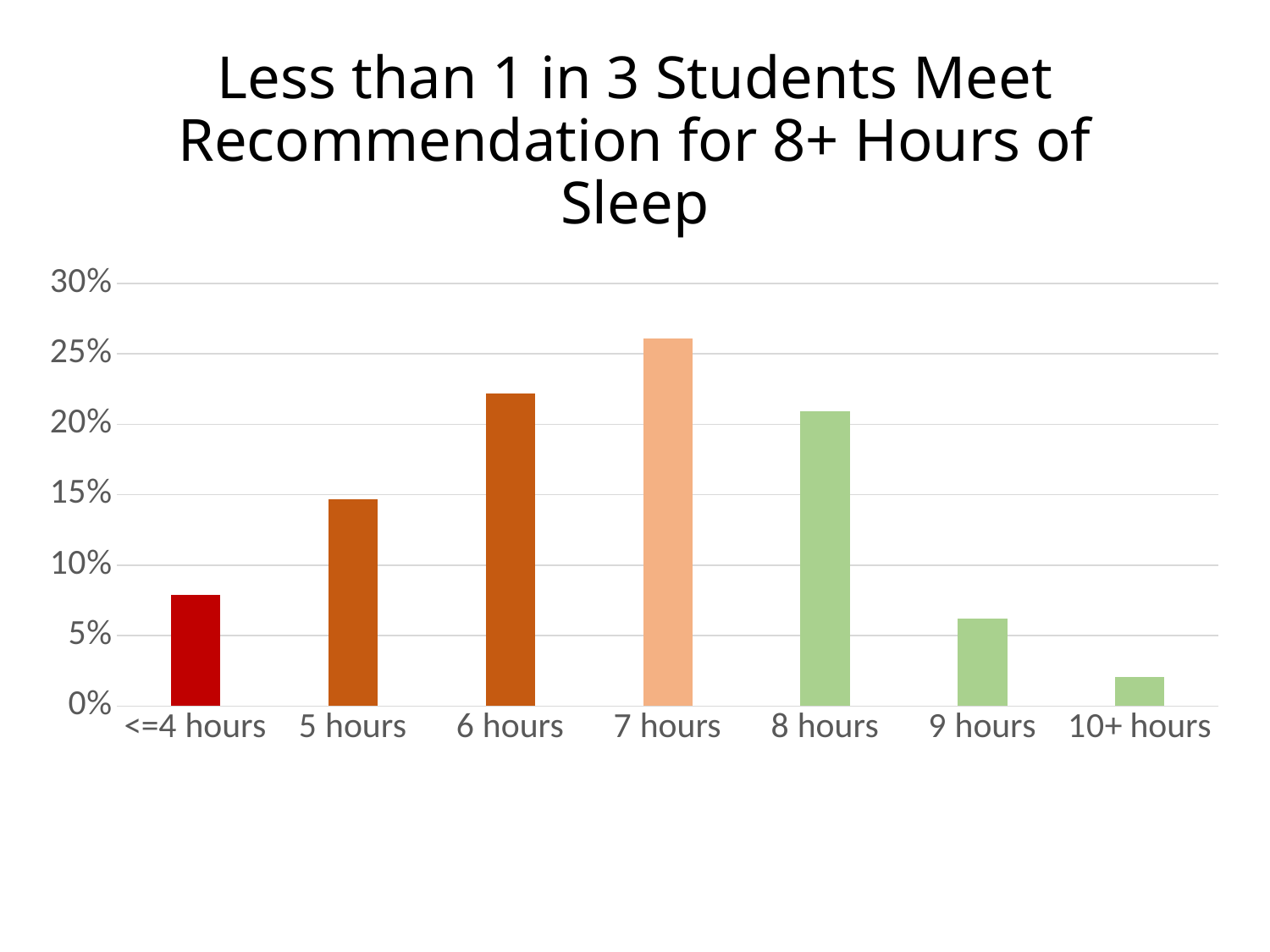
Which is larger, the value for 9 hours or the value for <=4 hours? <=4 hours Which category has the lowest value? 10+ hours Is the value for 7 hours greater or less than 25%? greater Is the value for 10+ hours greater or less than 5%? less Which category has the highest value? 7 hours Which is larger, the value for 5 hours or the value for 8 hours? 8 hours Is the value for <=4 hours greater or less than 10%? less What is the title of the chart? Less than 1 in 3 Students Meet Recommendation for 8+ Hours of Sleep What kind of chart is shown on the slide? bar chart What colour is the bar for <=4 hours? red How many sleep-duration categories are shown on the x axis? 7